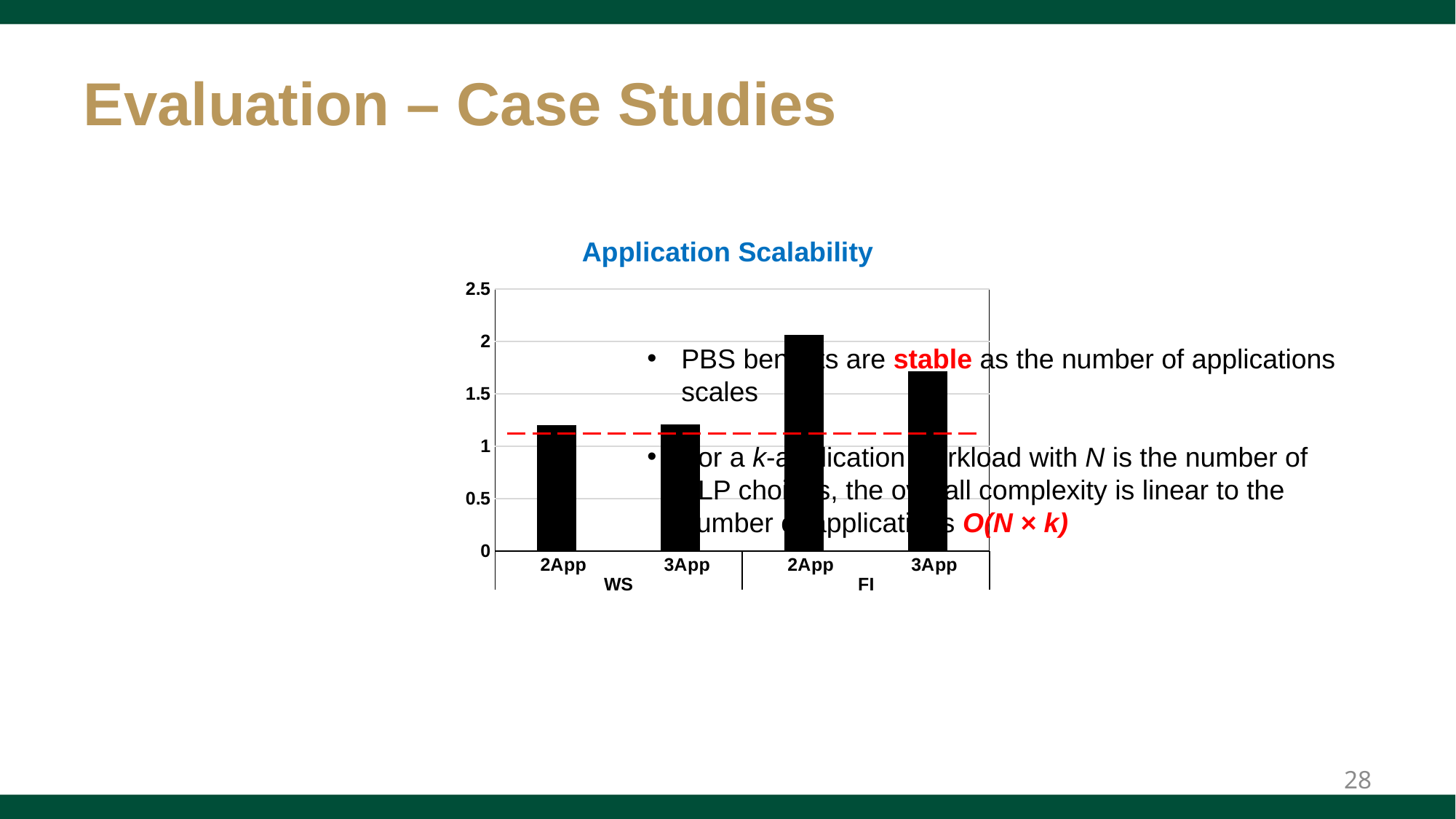
Is the value for FI 3App greater or less than 2? less Which is larger, the value for WS 3App or FI 3App? FI 3App Is the value for FI 2App greater or less than 2.5? less What is the title of the chart? Application Scalability How many bars are plotted in the chart? 4 Is the value for WS 2App greater or less than 1? greater How many groups are labelled on the x axis of the chart? 2 Which bar is the highest in the chart? FI 2App What type of chart is shown on the slide? bar chart Which is larger, the value for FI 2App or FI 3App? FI 2App